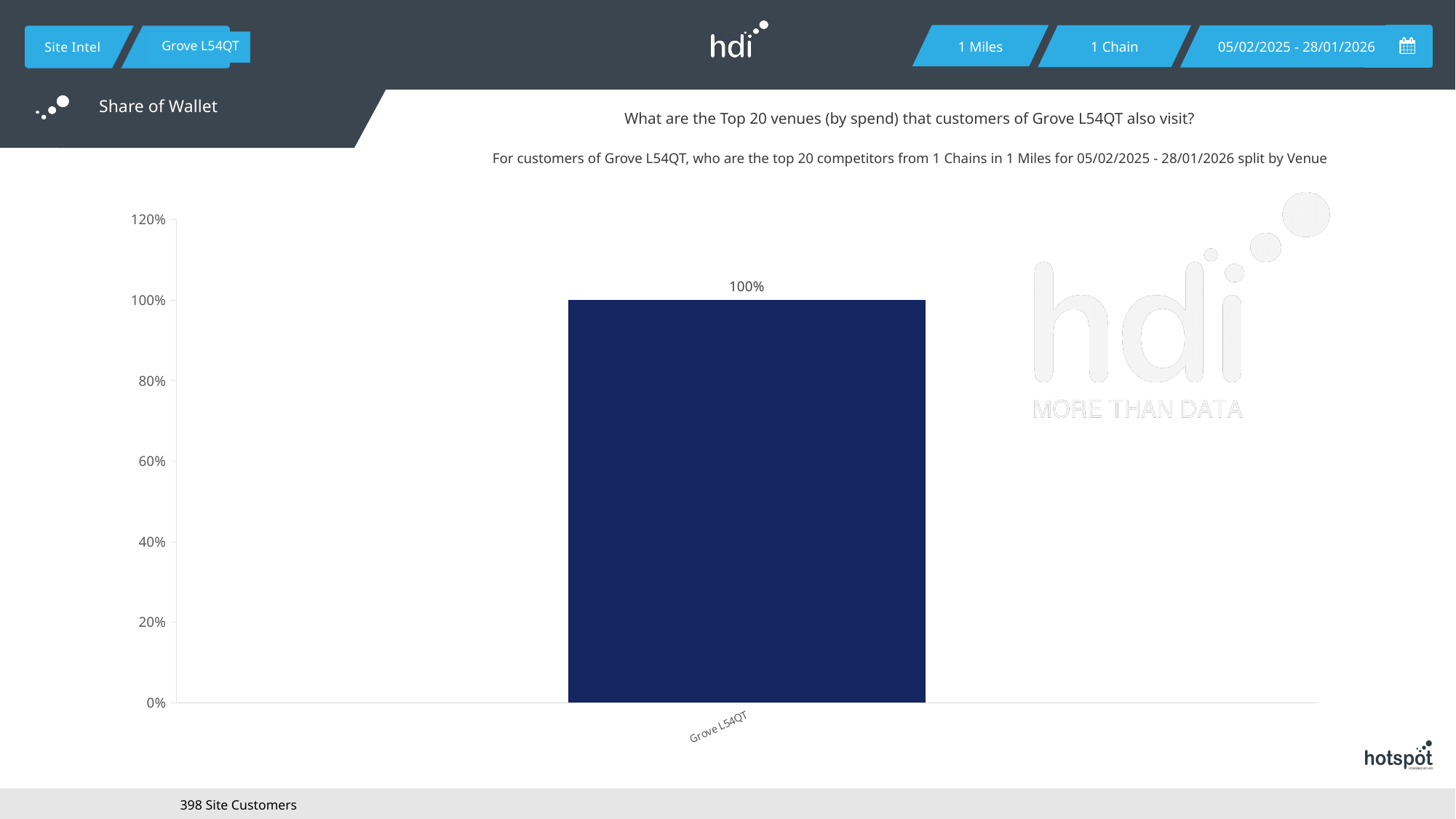
What is the label of the only category on the x axis? Grove L54QT What is the value shown for Grove L54QT? 100% Is the value for Grove L54QT greater or less than 80%? greater Is the value for Grove L54QT greater or less than 120%? less How many categories are plotted on the x axis? 1 What kind of chart is shown on the slide? bar chart What is the highest tick label shown on the y axis? 120% Which category has the highest value on the chart? Grove L54QT